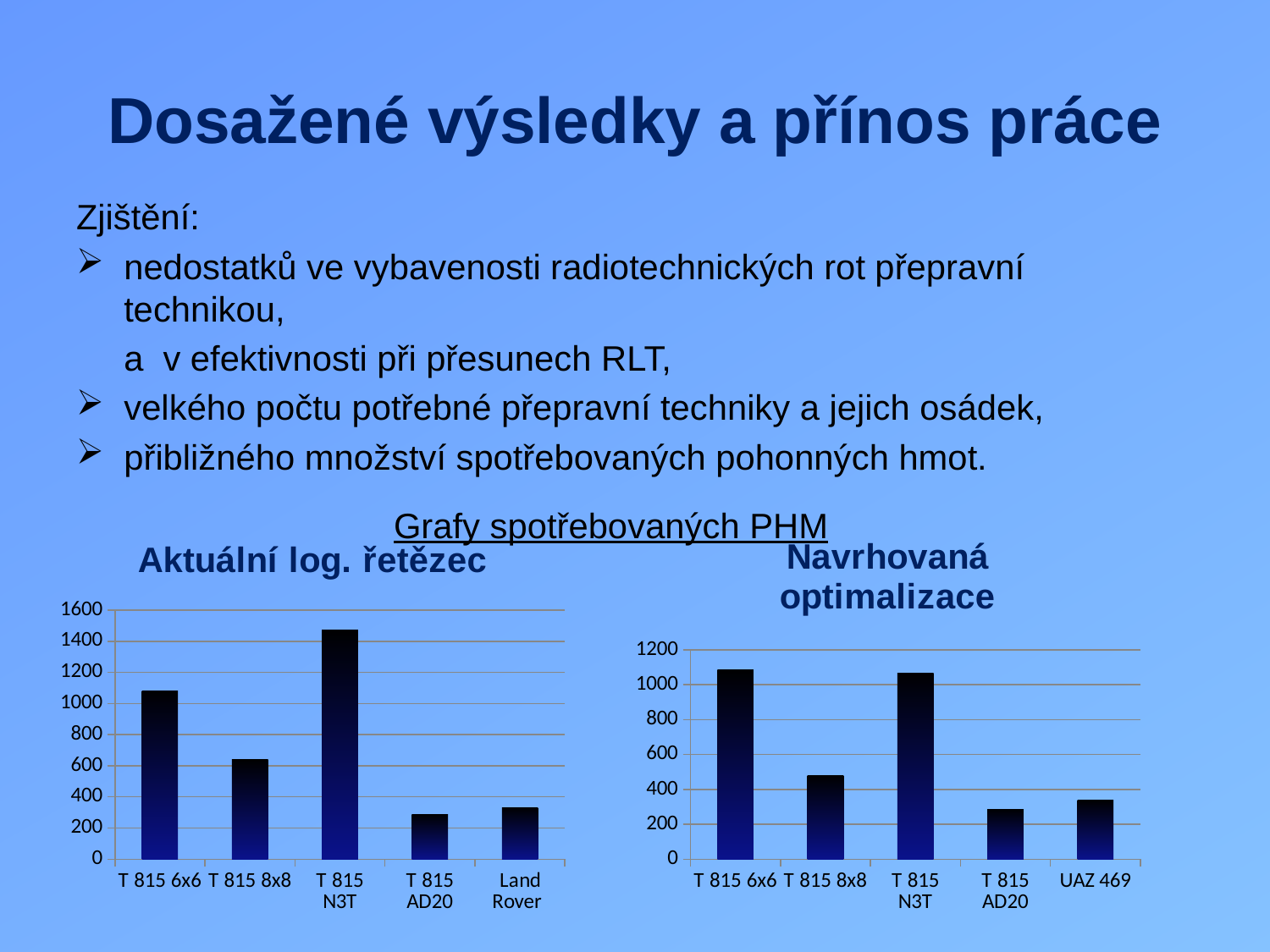
In the 'Navrhovaná optimalizace' chart, which is larger, the value for T 815 8x8 or the value for T 815 AD20? T 815 8x8 In the 'Aktuální log. řetězec' chart, is the value for T 815 6x6 greater or less than 1000? greater In the 'Aktuální log. řetězec' chart, is the value for T 815 N3T greater or less than 1400? greater In the 'Navrhovaná optimalizace' chart, is the value for T 815 6x6 greater or less than 1000? greater How many categories are shown on the 'Aktuální log. řetězec' chart? 5 What type of chart is the 'Aktuální log. řetězec' chart? bar chart In the 'Aktuální log. řetězec' chart, which category has the highest value? T 815 N3T How many categories are shown on the 'Navrhovaná optimalizace' chart? 5 What is the title of the chart on the right side of the slide? Navrhovaná optimalizace In the 'Aktuální log. řetězec' chart, which is larger, the value for T 815 6x6 or the value for T 815 8x8? T 815 6x6